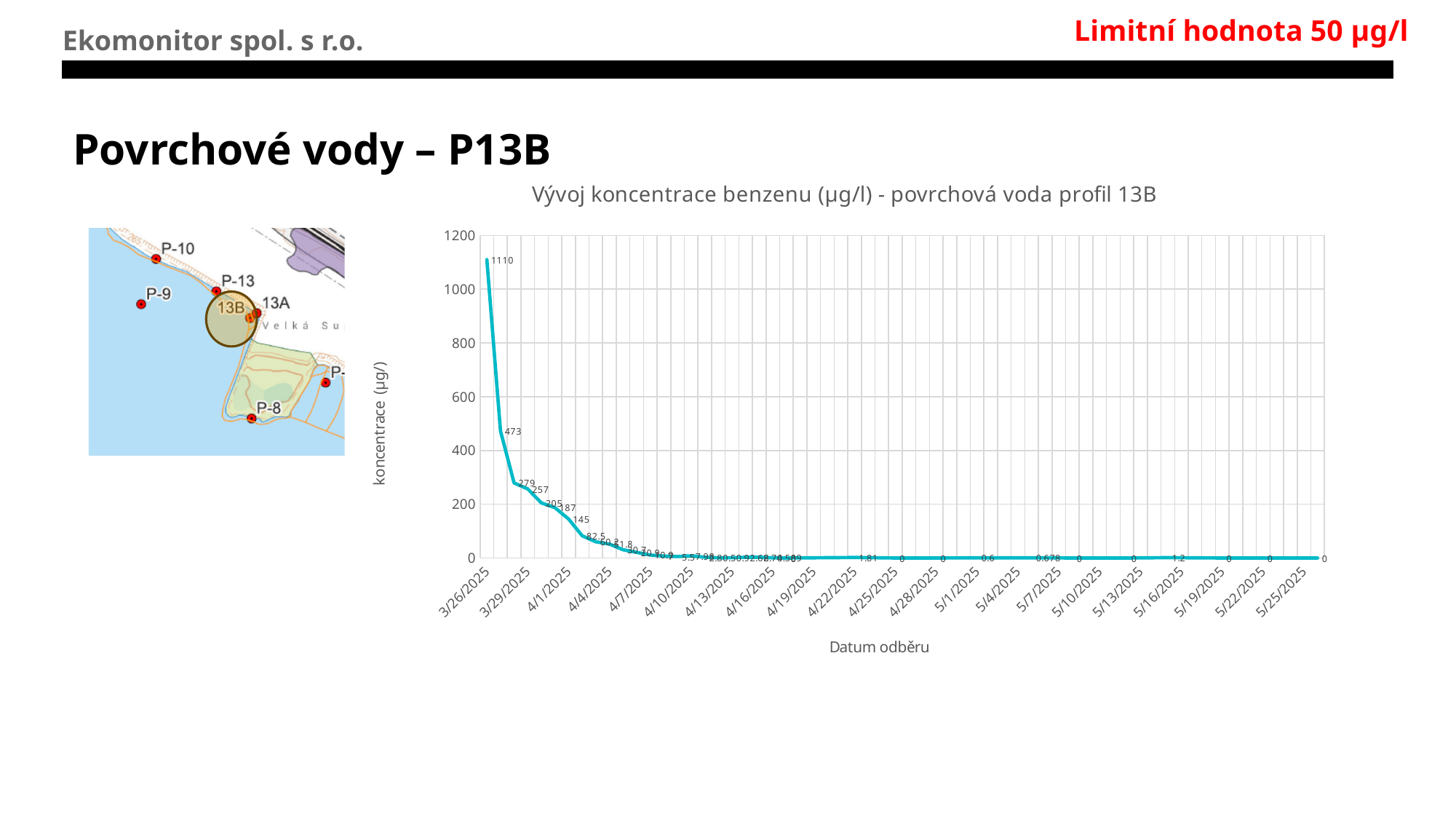
What is the second data label shown on the chart, after 1110? 473 What is the lowest value labelled on the chart? 0 What is the benzene concentration value at the first data point (3/26/2025)? 1110 Which is larger, the value labelled 279 or the value labelled 257? 279 What kind of chart is shown on the slide? line chart What is the title of the chart? Vývoj koncentrace benzenu (µg/l) - povrchová voda profil 13B What is the highest value plotted on the chart? 1110 What is the label of the y axis? koncentrace (µg/l) What is the difference between the first two labelled values, 1110 and 473? 637 Is the value at 3/26/2025 greater or less than 1000? greater Do the values rise or fall along the x axis over time? fall Is the value at 4/13/2025 greater or less than 200? less